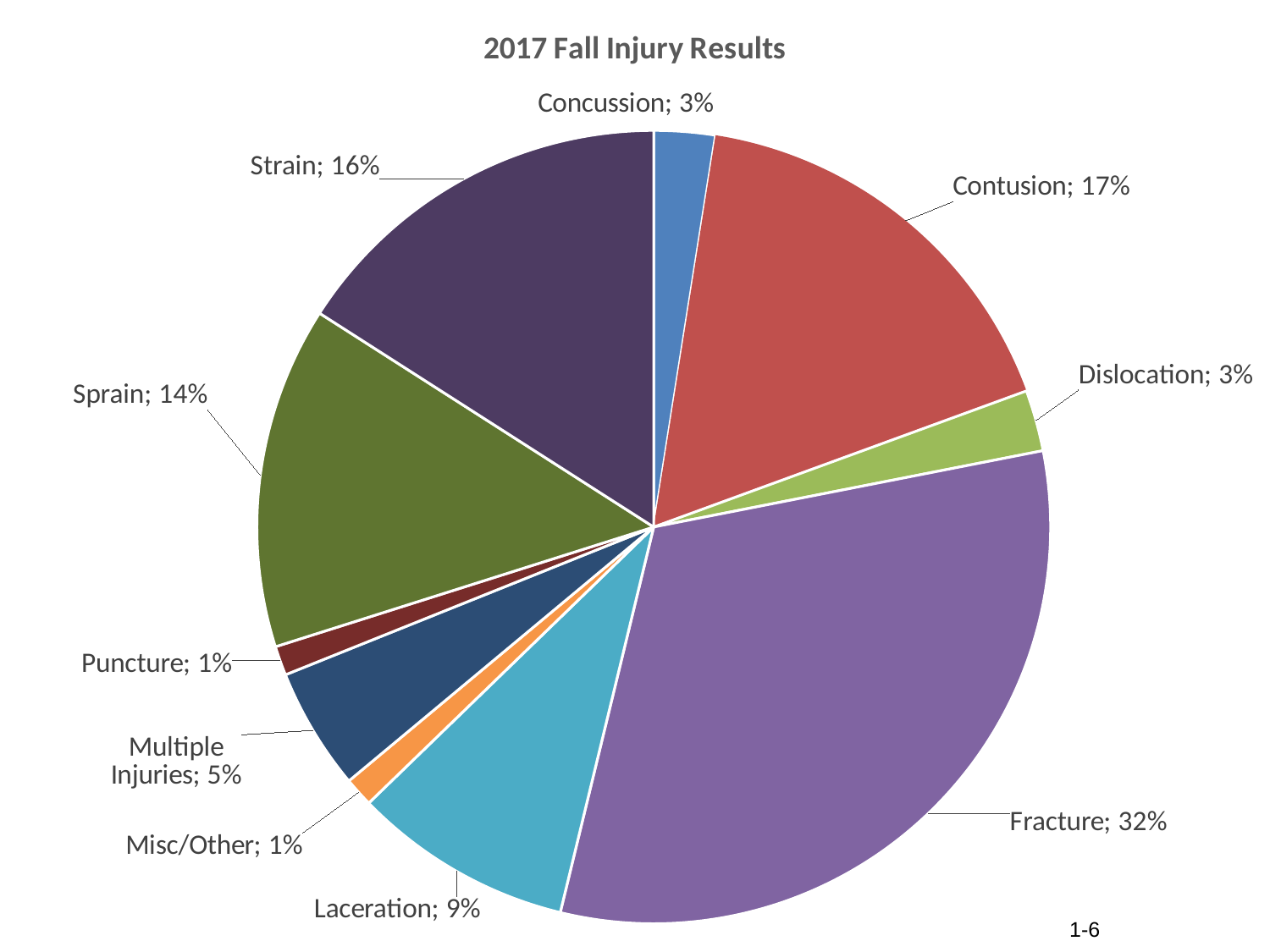
How many injury categories are shown in the pie chart? 10 Which is larger, the share for Sprain or the share for Laceration? Sprain Which injury type has the largest share of the pie? Fracture What share of the pie does Laceration represent? 9% What type of chart is shown on the slide? pie chart What is the combined share of Concussion and Dislocation? 6% What is the difference in percentage points between Fracture and Strain? 16 What is the value shown for Contusion? 17% Which injury types have the smallest share, at 1%? Puncture and Misc/Other What is the value shown for Multiple Injuries? 5% What is the title of the chart? 2017 Fall Injury Results What percentage of fall injuries were fractures? 32%